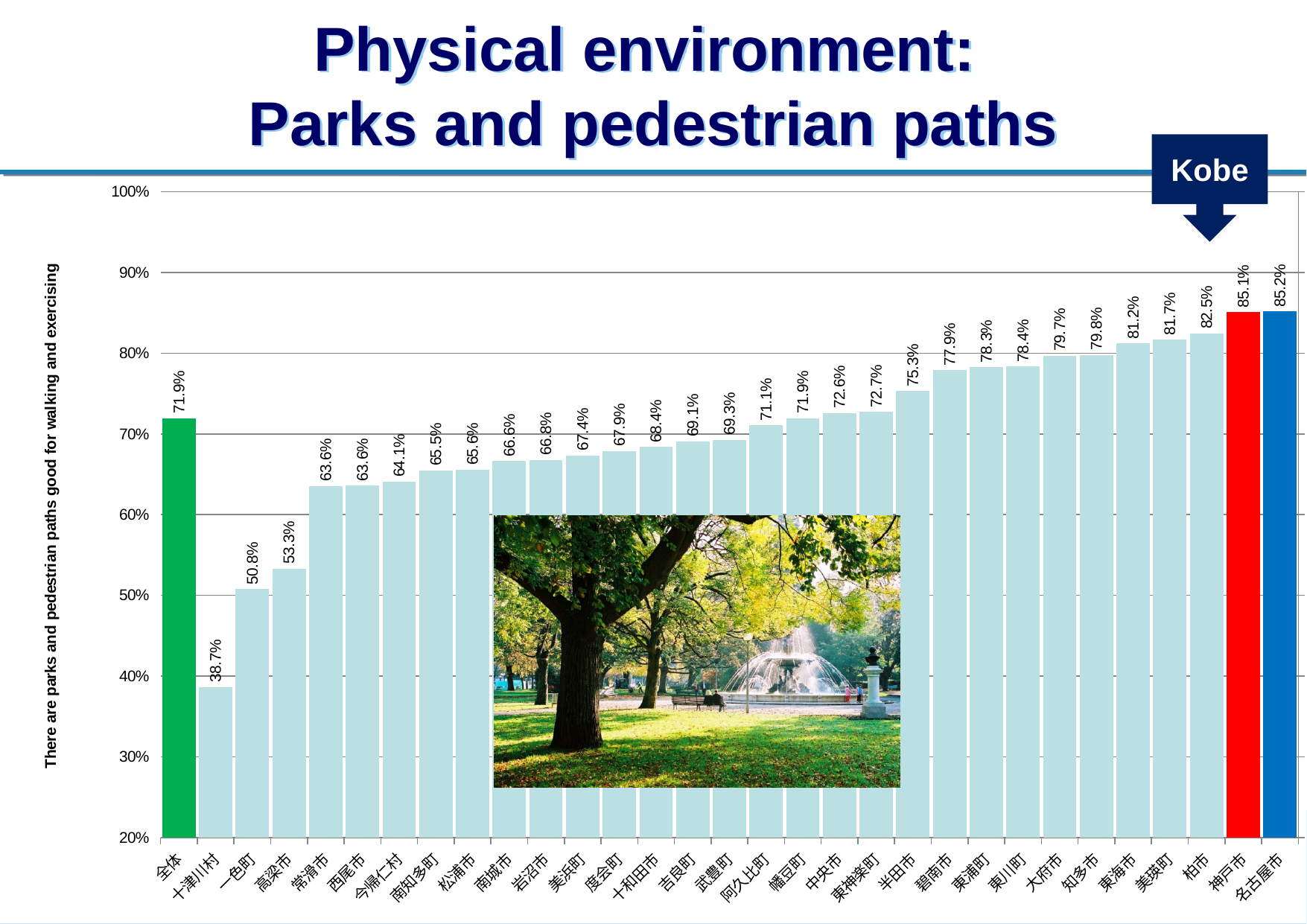
What is the difference between the values for 全体 and 十津川村? 33.2 percentage points Which has a larger value, 柏市 or 半田市? 柏市 Which category has the lowest value in the chart? 十津川村 What is the value for 半田市 in the chart? 75.3% What is the value for 全体 (the first bar) in the chart? 71.9% Which category has the highest value in the chart? 名古屋市 What is the difference between the values for 名古屋市 and 神戸市? 0.1 percentage points What colour is the bar for 神戸市 (Kobe)? red Is the value for 十津川村 greater or less than 40%? less What is the value for 神戸市 (Kobe) in the chart? 85.1% What kind of chart is shown on the slide? bar chart How many bars are plotted in the chart? 31